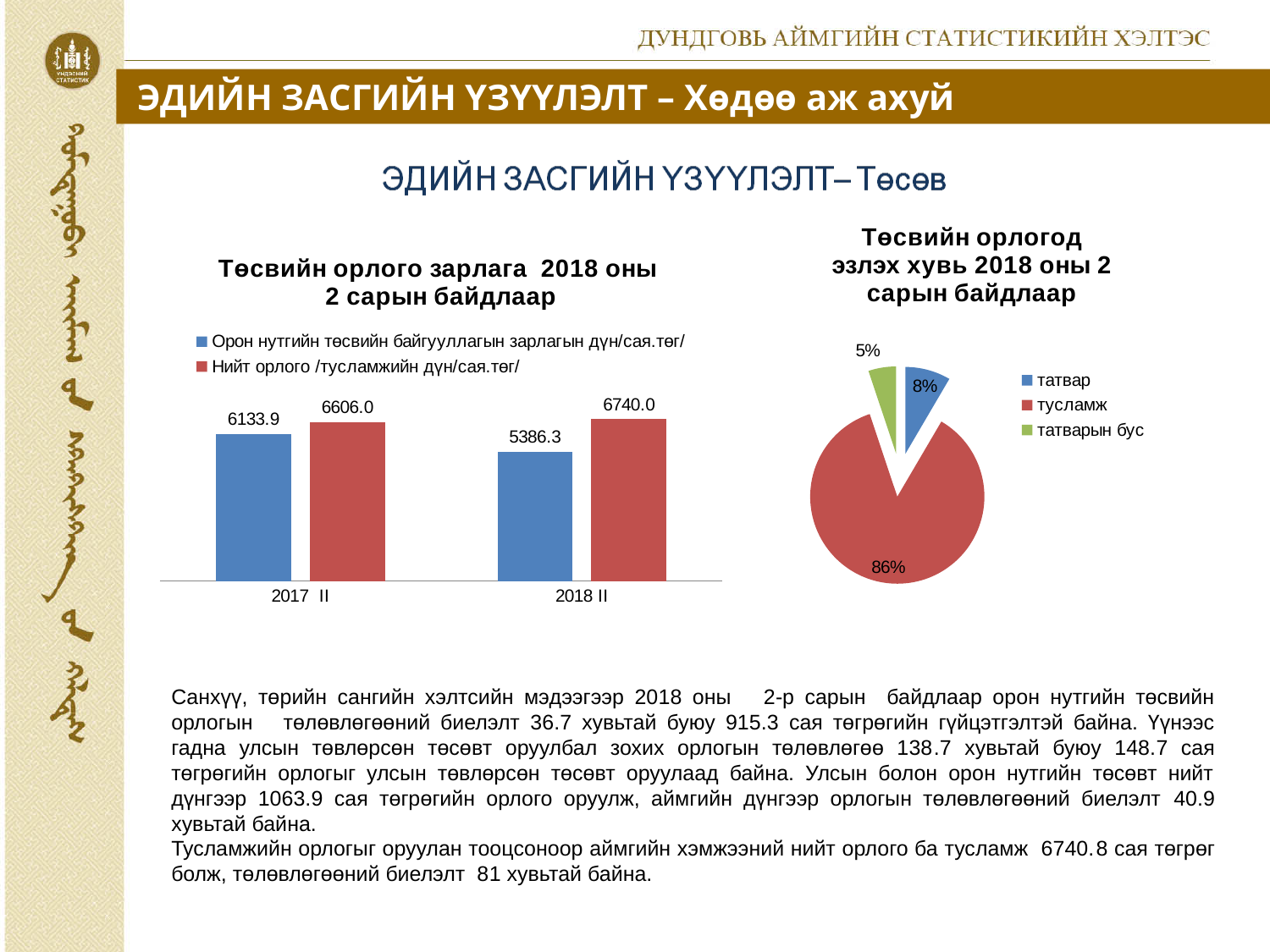
In the bar chart 'Төсвийн орлого зарлага 2018 оны 2 сарын байдлаар', how many categories are shown on the x axis? 2 In the bar chart 'Төсвийн орлого зарлага 2018 оны 2 сарын байдлаар', does 'Орон нутгийн төсвийн байгууллагын зарлагын дүн/сая.төг/' rise or fall from 2017 II to 2018 II? fall In the bar chart 'Төсвийн орлого зарлага 2018 оны 2 сарын байдлаар', what is the difference between 'Нийт орлого /тусламжийн дүн/сая.төг/' and 'Орон нутгийн төсвийн байгууллагын зарлагын дүн/сая.төг/' for 2018 II? 1353.7 In the bar chart 'Төсвийн орлого зарлага 2018 оны 2 сарын байдлаар', what is the value of 'Нийт орлого /тусламжийн дүн/сая.төг/' for 2018 II? 6740.0 In the pie chart 'Төсвийн орлогод эзлэх хувь 2018 оны 2 сарын байдлаар', what share does 'тусламж' have? 86% In the bar chart 'Төсвийн орлого зарлага 2018 оны 2 сарын байдлаар', what is the value of 'Орон нутгийн төсвийн байгууллагын зарлагын дүн/сая.төг/' for 2018 II? 5386.3 What kind of chart is the chart on the left of the slide? bar chart In the pie chart 'Төсвийн орлогод эзлэх хувь 2018 оны 2 сарын байдлаар', what colour is the 'татвар' slice? blue In the bar chart 'Төсвийн орлого зарлага 2018 оны 2 сарын байдлаар', what is the value of 'Орон нутгийн төсвийн байгууллагын зарлагын дүн/сая.төг/' for 2017 II? 6133.9 In the pie chart 'Төсвийн орлогод эзлэх хувь 2018 оны 2 сарын байдлаар', which slice is the smallest? татварын бус In the bar chart 'Төсвийн орлого зарлага 2018 оны 2 сарын байдлаар', which is larger for 2017 II: 'Орон нутгийн төсвийн байгууллагын зарлагын дүн/сая.төг/' or 'Нийт орлого /тусламжийн дүн/сая.төг/'? Нийт орлого /тусламжийн дүн/сая.төг/ In the bar chart 'Төсвийн орлого зарлага 2018 оны 2 сарын байдлаар', how many series does the legend list? 2